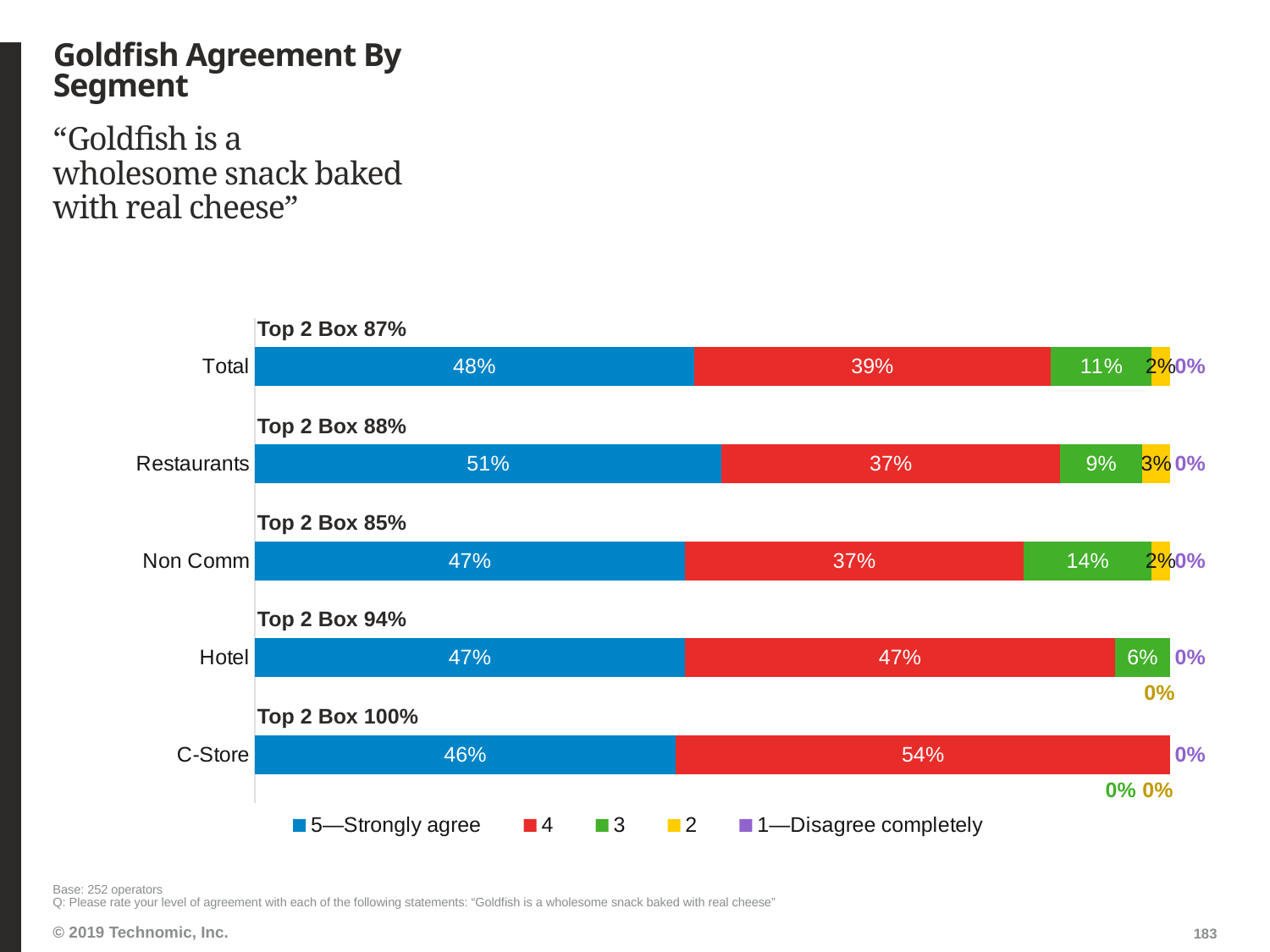
How many series does the legend list? 5 What is the combined total of the "5—Strongly agree" and "4" values for Non Comm? 84% What percentage of Restaurants respondents chose "5—Strongly agree"? 51% What is the "3" value for Non Comm? 14% Which segment has the highest "5—Strongly agree" percentage? Restaurants What is the value for the "4" series for C-Store? 54% Which is larger: the "3" value for Total or the "3" value for Restaurants? Total Which segment has the lowest "5—Strongly agree" percentage? C-Store What is the Top 2 Box value shown for Hotel? 94% What kind of chart is shown on the slide? Stacked bar chart How many segments (categories) are shown on the chart? 5 What is the difference between the "4" value for C-Store and the "4" value for Total? 15%